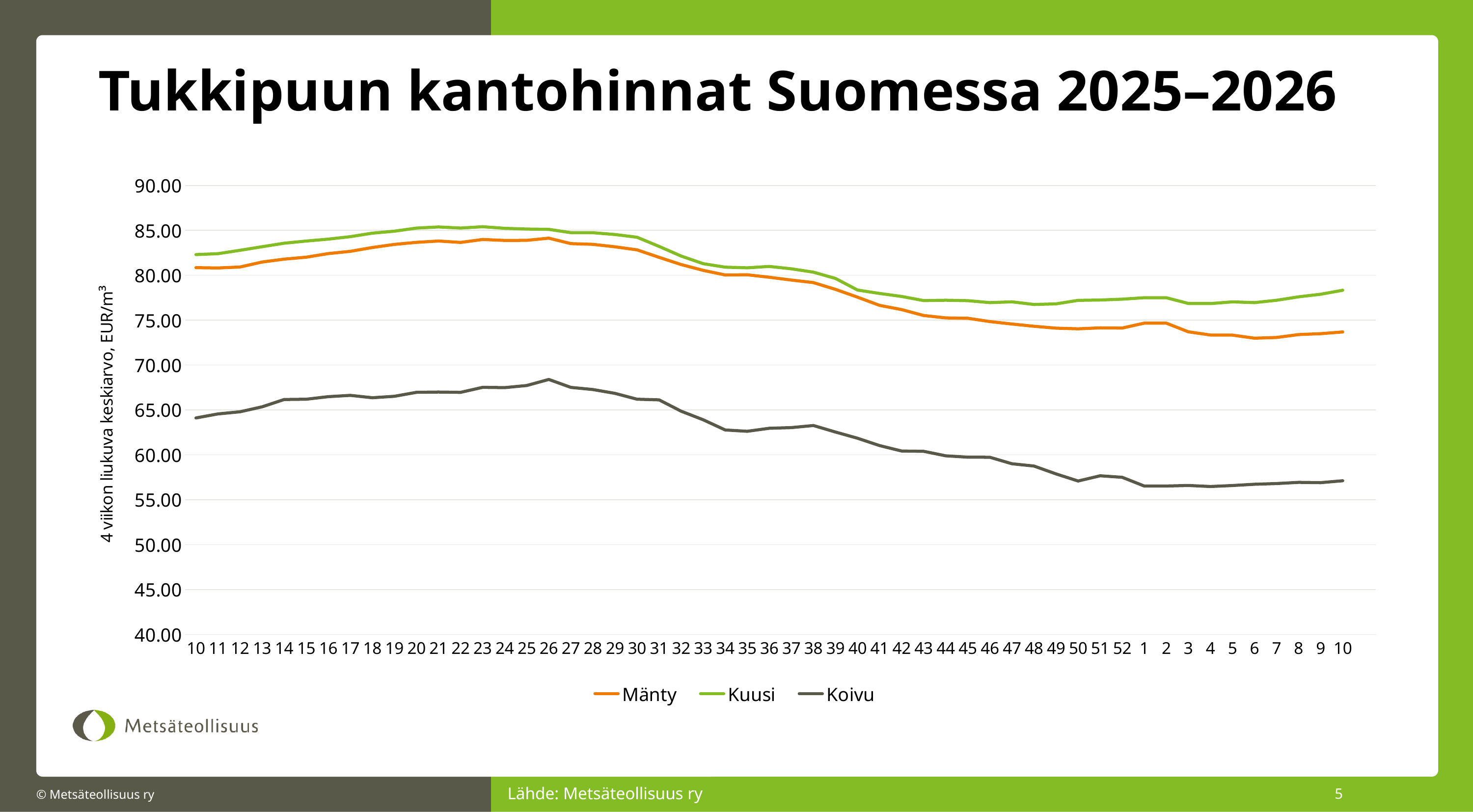
Is the value for Koivu at week 26 greater or less than 65? greater Is the value for Mänty at week 6 greater or less than 75? less At which week does the Koivu line reach its highest point? 26 Which series has the highest values across the chart? Kuusi How many series does the legend list? 3 What kind of chart is shown on the slide? line chart Which series has the lowest values across the chart? Koivu Is the value for Kuusi at the first week (10) greater or less than 80? greater Which series are listed in the legend? Mänty, Kuusi, Koivu What is the title of the chart? Tukkipuun kantohinnat Suomessa 2025–2026 Does the Koivu line rise or fall from week 26 to week 1? fall